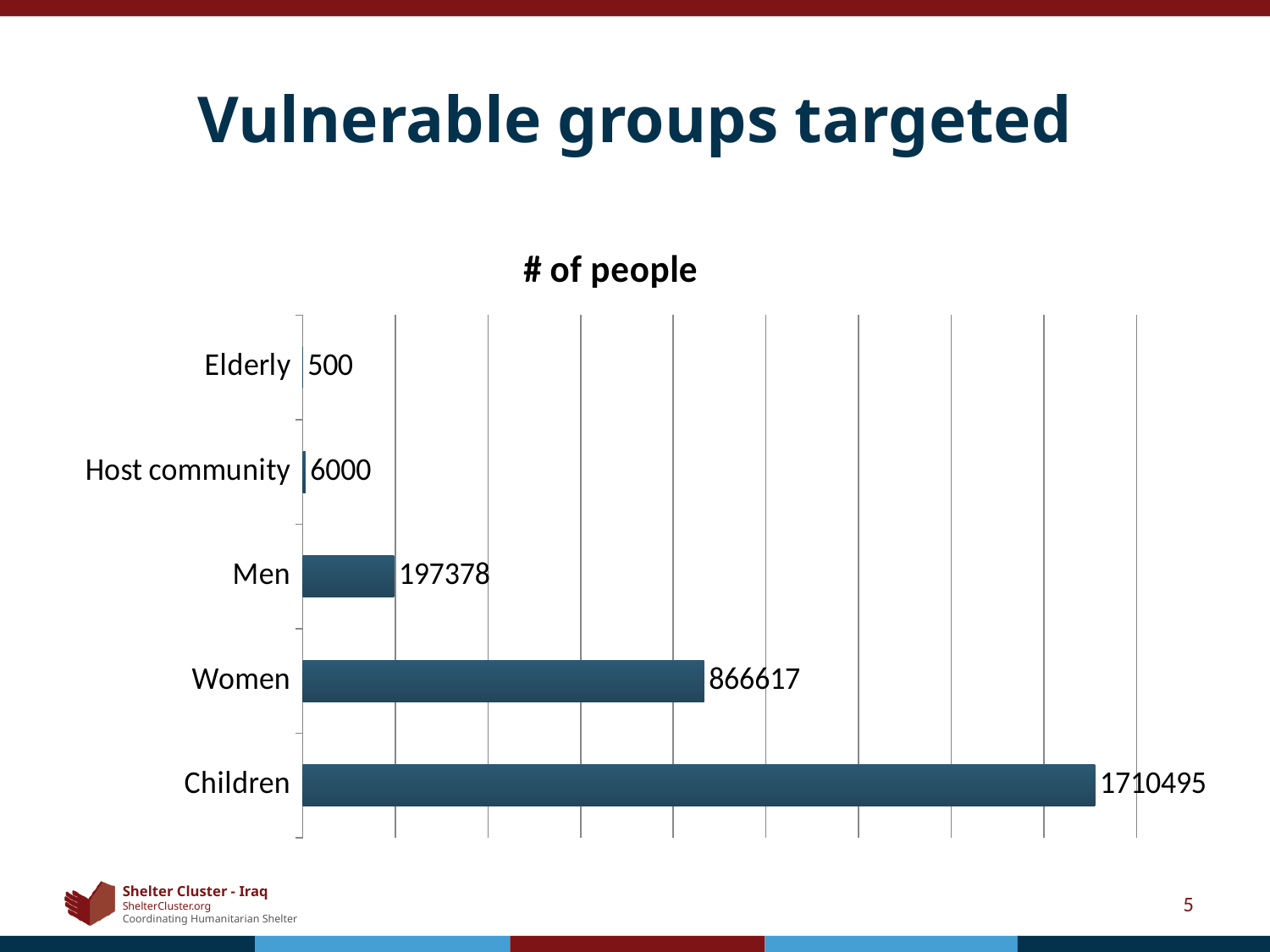
What is the number of people for Women? 866617 What is the number of people for Children? 1710495 What is the number of people for Men? 197378 Which group has the lowest number of people? Elderly Which group has the highest number of people? Children What is the number of people for Elderly? 500 What kind of chart is shown on the slide? Bar chart Which is larger, the value for Men or the value for Host community? Men How many groups are shown in the chart? 5 What is the difference between the number of people for Children and Women? 843878 What is the number of people for Host community? 6000 What is the difference between the number of people for Women and Men? 669239